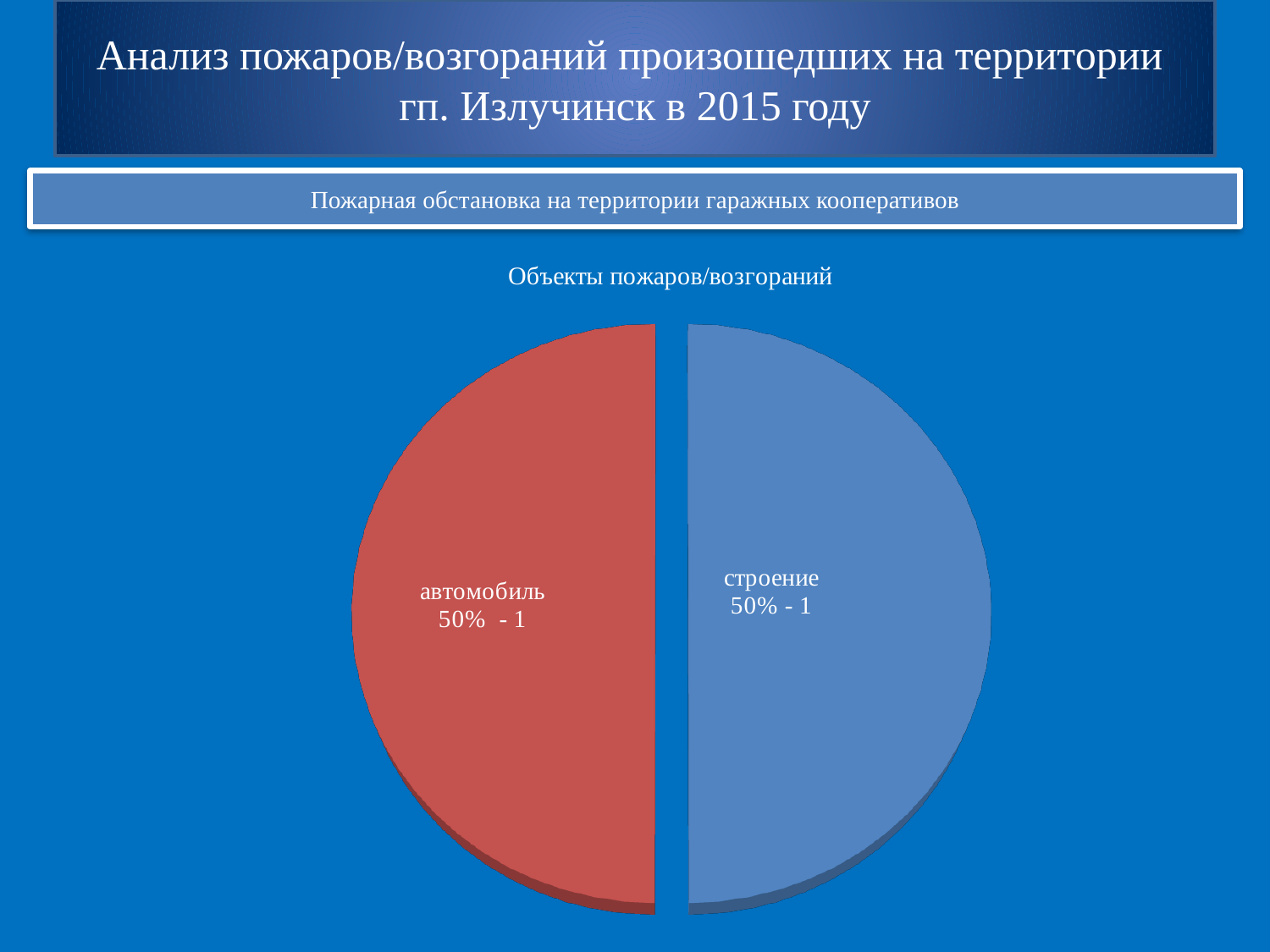
Which colour is the "автомобиль" slice? red What is the total count across both slices of the pie? 2 What share of the pie does the "автомобиль" slice represent? 50% What share of the pie does the "строение" slice represent? 50% What count is shown for the "автомобиль" slice? 1 How many slices does the pie chart have? 2 What count is shown for the "строение" slice? 1 What kind of chart is shown on the slide? pie chart What is the difference between the counts for "автомобиль" and "строение"? 0 What is the title of the chart? Объекты пожаров/возгораний